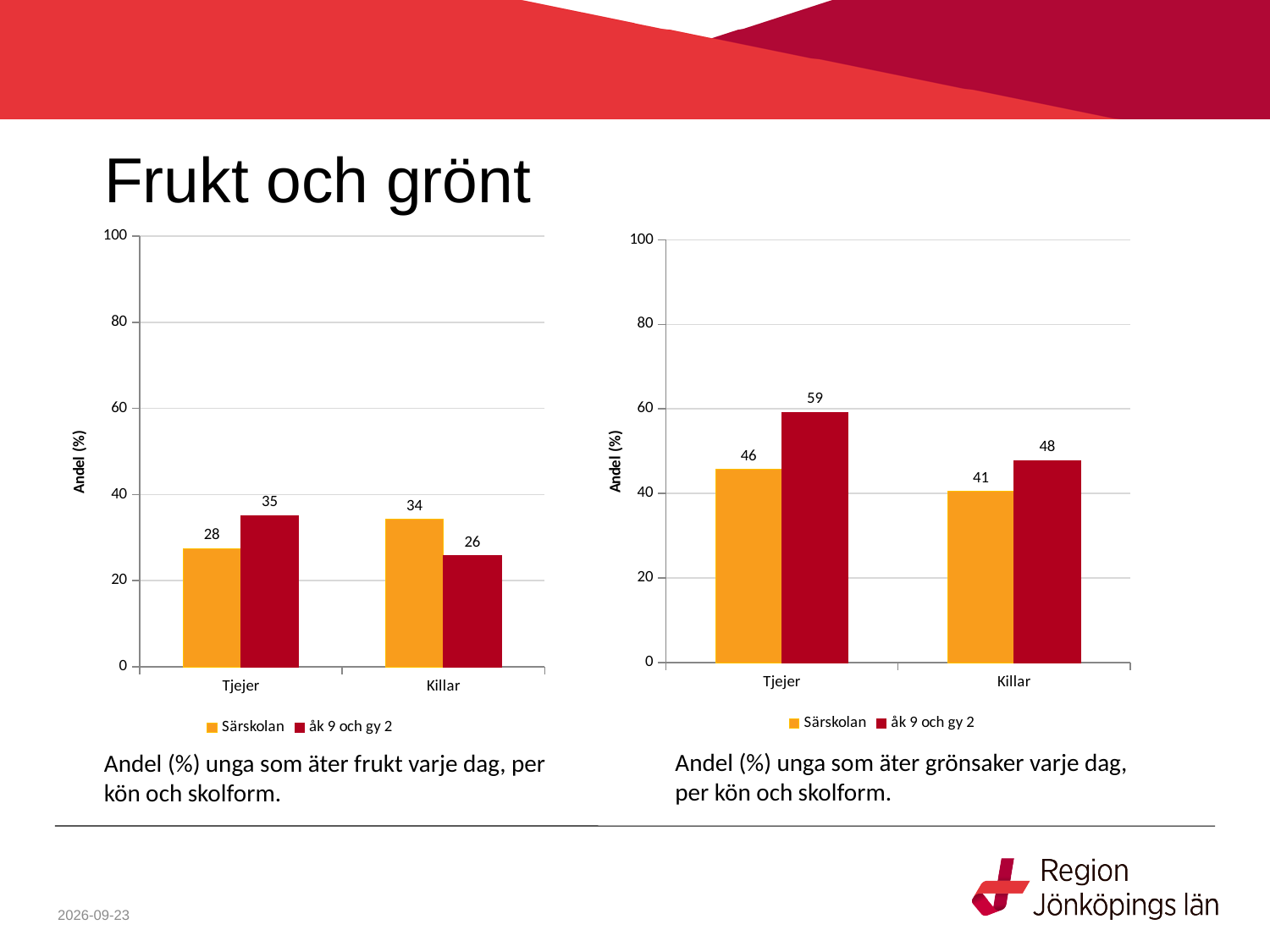
In the right chart (vegetables every day), what is the value for Särskolan among Killar? 41 In the right chart (vegetables every day), what is the value for åk 9 och gy 2 among Tjejer? 59 In the left chart (fruit every day), what is the value for åk 9 och gy 2 among Killar? 26 In the right chart (vegetables every day), which group and series has the highest value? åk 9 och gy 2, Tjejer In the left chart (fruit every day), which is larger among Killar: Särskolan or åk 9 och gy 2? Särskolan In the right chart (vegetables every day), is the value for Särskolan among Tjejer greater or less than 40? greater In the left chart (fruit every day), what is the value for Särskolan among Tjejer? 28 What kind of chart is the right chart (vegetables every day)? bar chart In the left chart (fruit every day), which group and series has the lowest value? åk 9 och gy 2, Killar In the left chart (fruit every day), what is the difference between åk 9 och gy 2 and Särskolan among Tjejer? 7 How many series does the legend of the left chart list? 2 In the right chart (vegetables every day), what is the difference between åk 9 och gy 2 and Särskolan among Killar? 7